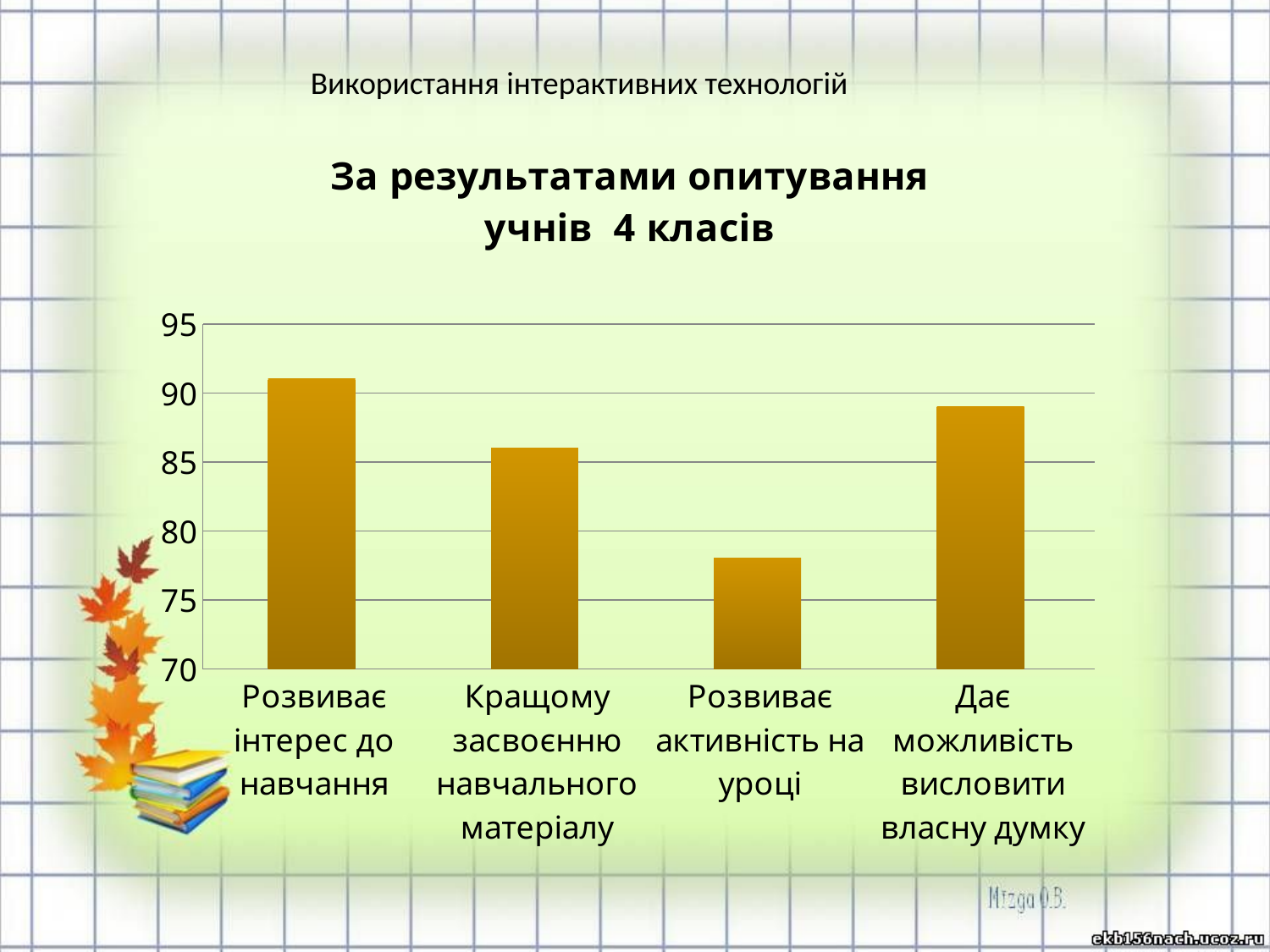
What kind of chart is shown on the slide? bar chart Which category has the highest bar in the chart? Розвиває інтерес до навчання Which is larger: the value for "Кращому засвоєнню навчального матеріалу" or the value for "Розвиває активність на уроці"? Кращому засвоєнню навчального матеріалу Is the value for "Розвиває активність на уроці" greater or less than 80? less Is the value for "Розвиває інтерес до навчання" greater or less than 85? greater What is the lowest value shown on the vertical axis of the chart? 70 Is the value for "Кращому засвоєнню навчального матеріалу" greater or less than 80? greater What is the title of the chart? За результатами опитування учнів 4 класів How many categories are plotted in the chart? 4 Which category has the lowest bar in the chart? Розвиває активність на уроці Which is larger: the value for "Дає можливість висловити власну думку" or the value for "Кращому засвоєнню навчального матеріалу"? Дає можливість висловити власну думку